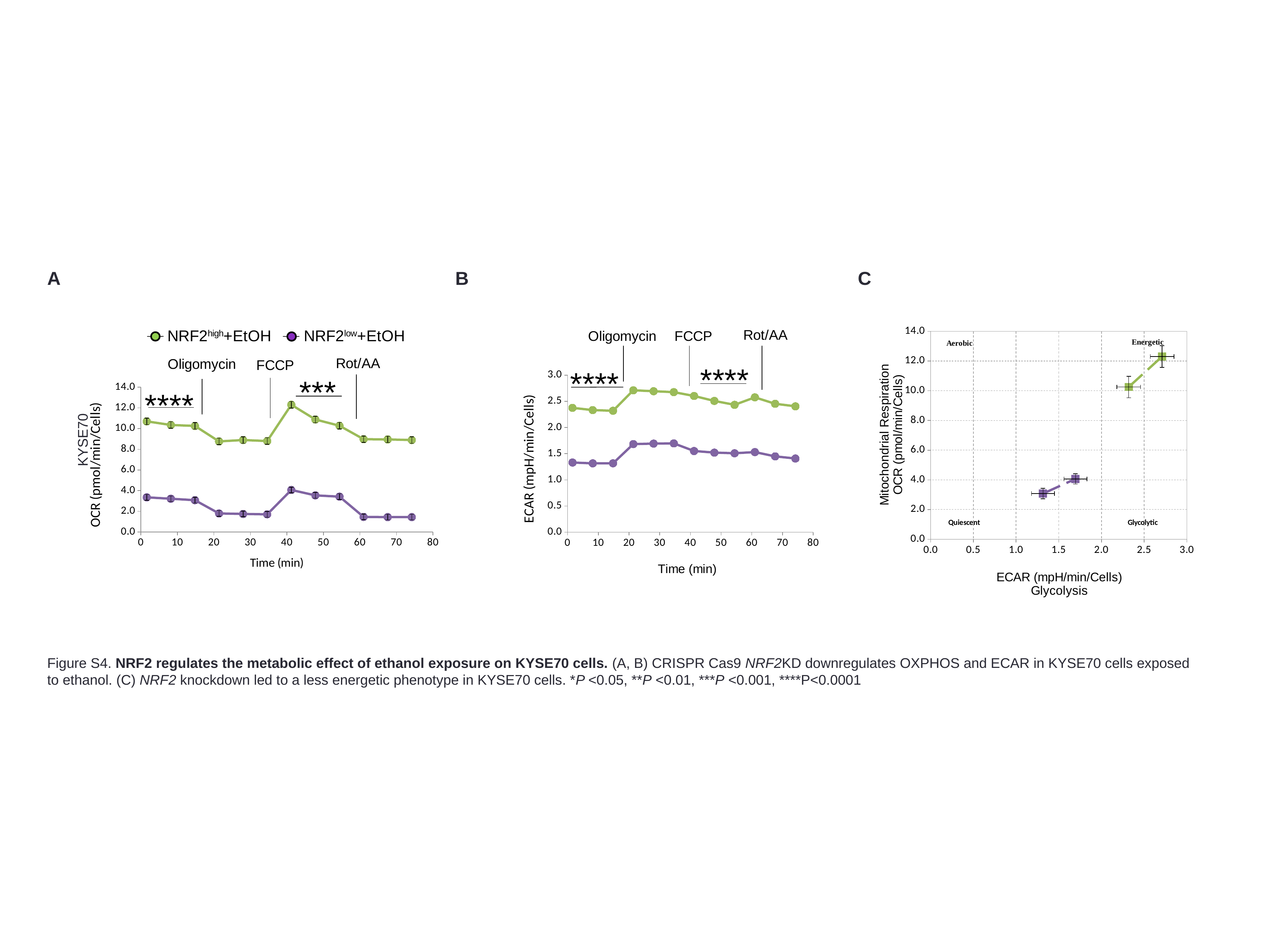
In chart C, which quadrant label do the green points fall in? Energetic In chart A, is the OCR value for NRF2high+EtOH at about 41 min greater or less than 10.0? greater In chart B, which series has the lower ECAR throughout, NRF2high+EtOH or NRF2low+EtOH? NRF2low+EtOH How many series does the legend above chart A list? 2 In chart A, how many data points are plotted for the NRF2high+EtOH series? 12 What kind of chart is chart A (OCR vs Time)? line chart In chart A, which series has the higher OCR at the first time point, NRF2high+EtOH or NRF2low+EtOH? NRF2high+EtOH In chart A, is the OCR value for NRF2low+EtOH at about 61 min greater or less than 2.0? less In chart B, is the ECAR value for NRF2low+EtOH at the first time point greater or less than 1.5? less What is the x-axis label of chart B? Time (min)